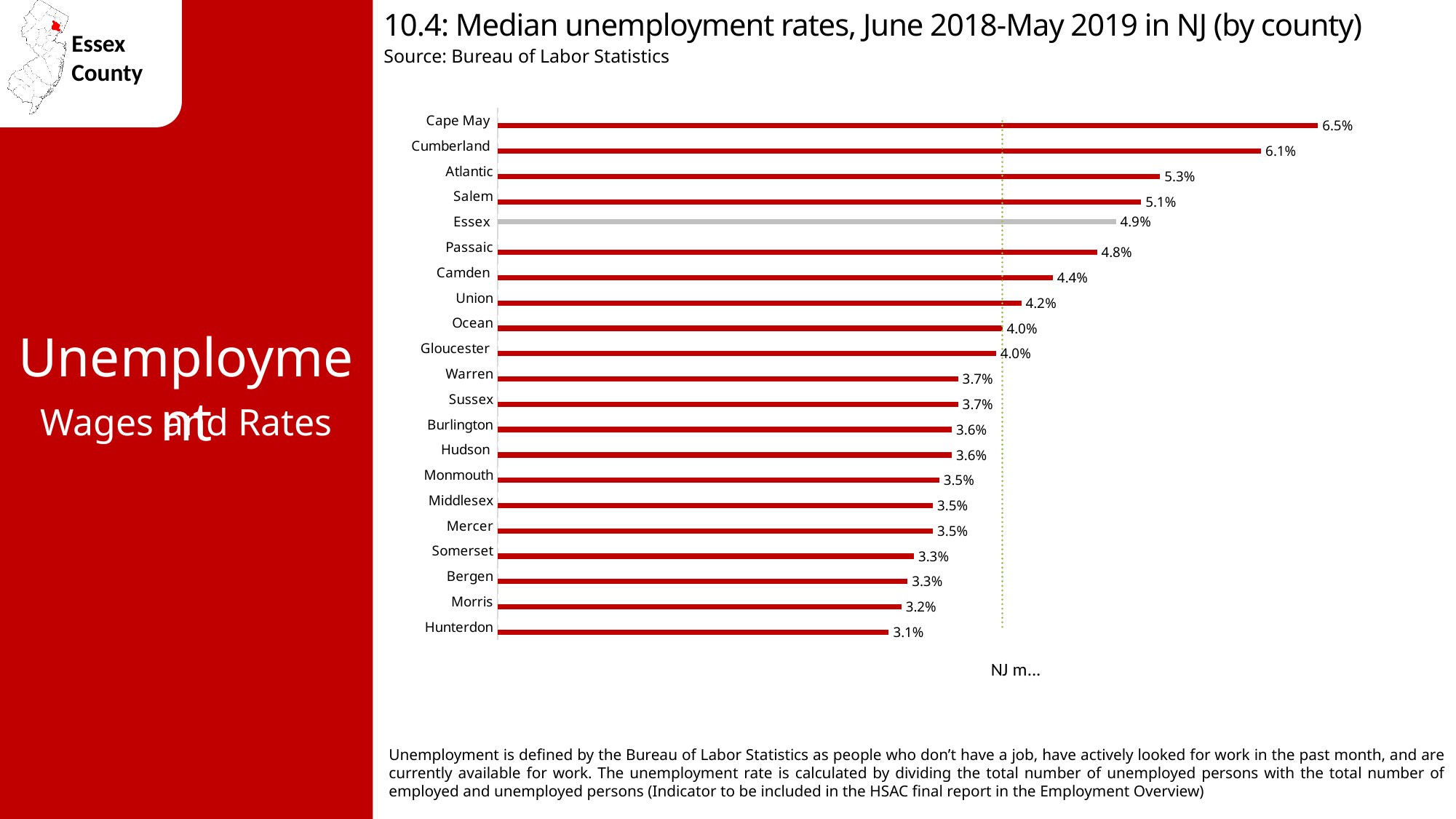
What is the difference between the median unemployment rates of Cape May and Hunterdon? 3.4% Which county has the lowest median unemployment rate? Hunterdon Which county has a higher median unemployment rate, Atlantic or Camden? Atlantic Which county has the highest median unemployment rate? Cape May What is the median unemployment rate for Hudson County? 3.6% What type of chart is used to show the median unemployment rates? Bar chart Which county's bar is shown in grey rather than red? Essex What is the median unemployment rate for Cumberland County? 6.1% How many counties are shown in the chart? 21 What is the median unemployment rate for Essex County? 4.9% What is the difference between the median unemployment rates of Essex and Passaic? 0.1% Which county has a higher median unemployment rate, Morris or Union? Union